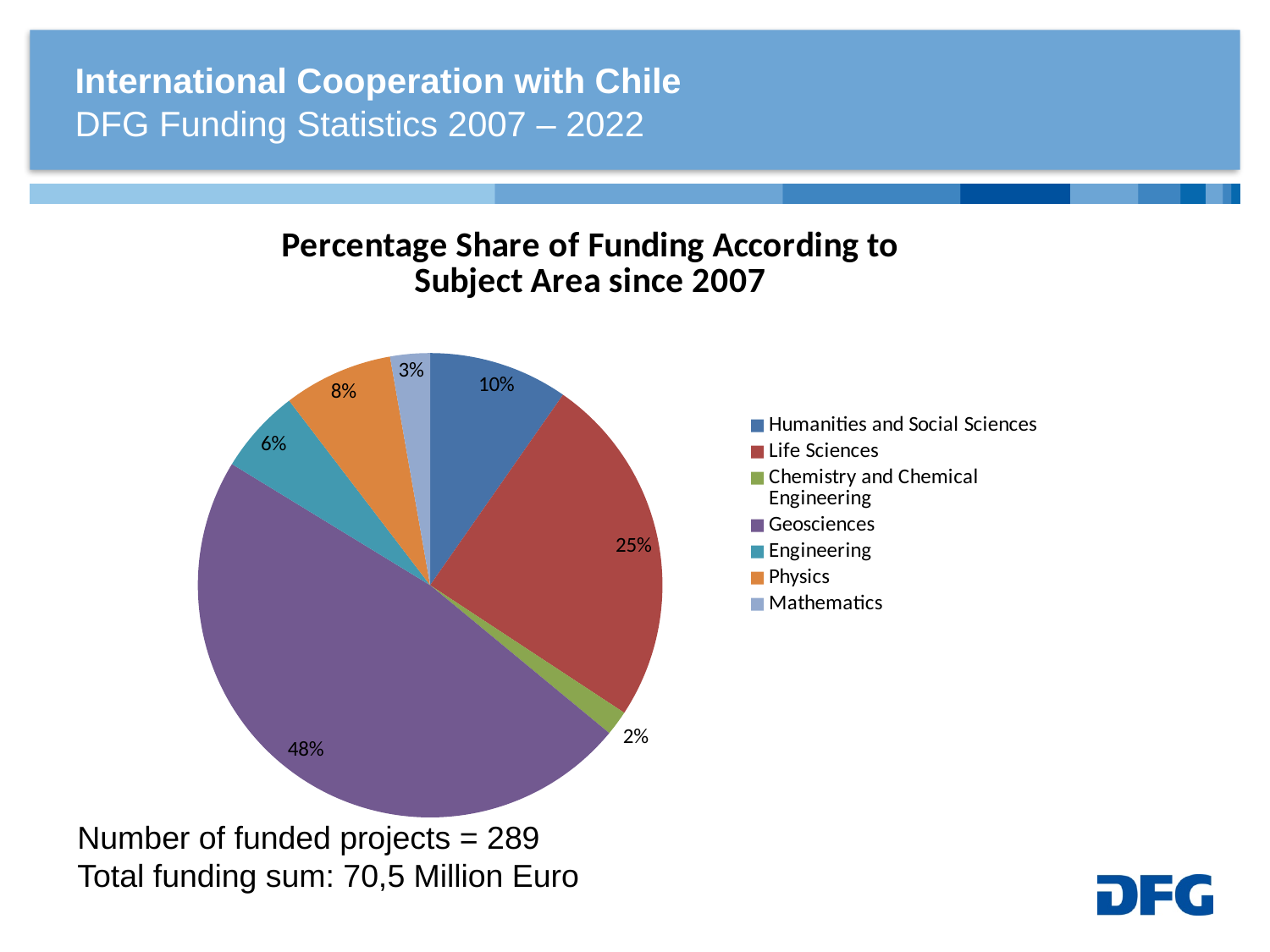
What is the title of the chart? Percentage Share of Funding According to Subject Area since 2007 Which has a larger share of funding, Engineering or Physics? Physics What is the percentage share of funding for Life Sciences? 25% Which subject area has the smallest share of funding? Chemistry and Chemical Engineering Which subject area has the largest share of funding? Geosciences What is the percentage share of funding for Physics? 8% What is the percentage share of funding for Geosciences? 48% What is the difference in percentage share between Geosciences and Life Sciences? 23% What type of chart is shown on the slide? pie chart What is the percentage share of funding for Mathematics? 3% What is the percentage share of funding for Humanities and Social Sciences? 10% How many subject areas are listed in the legend? 7